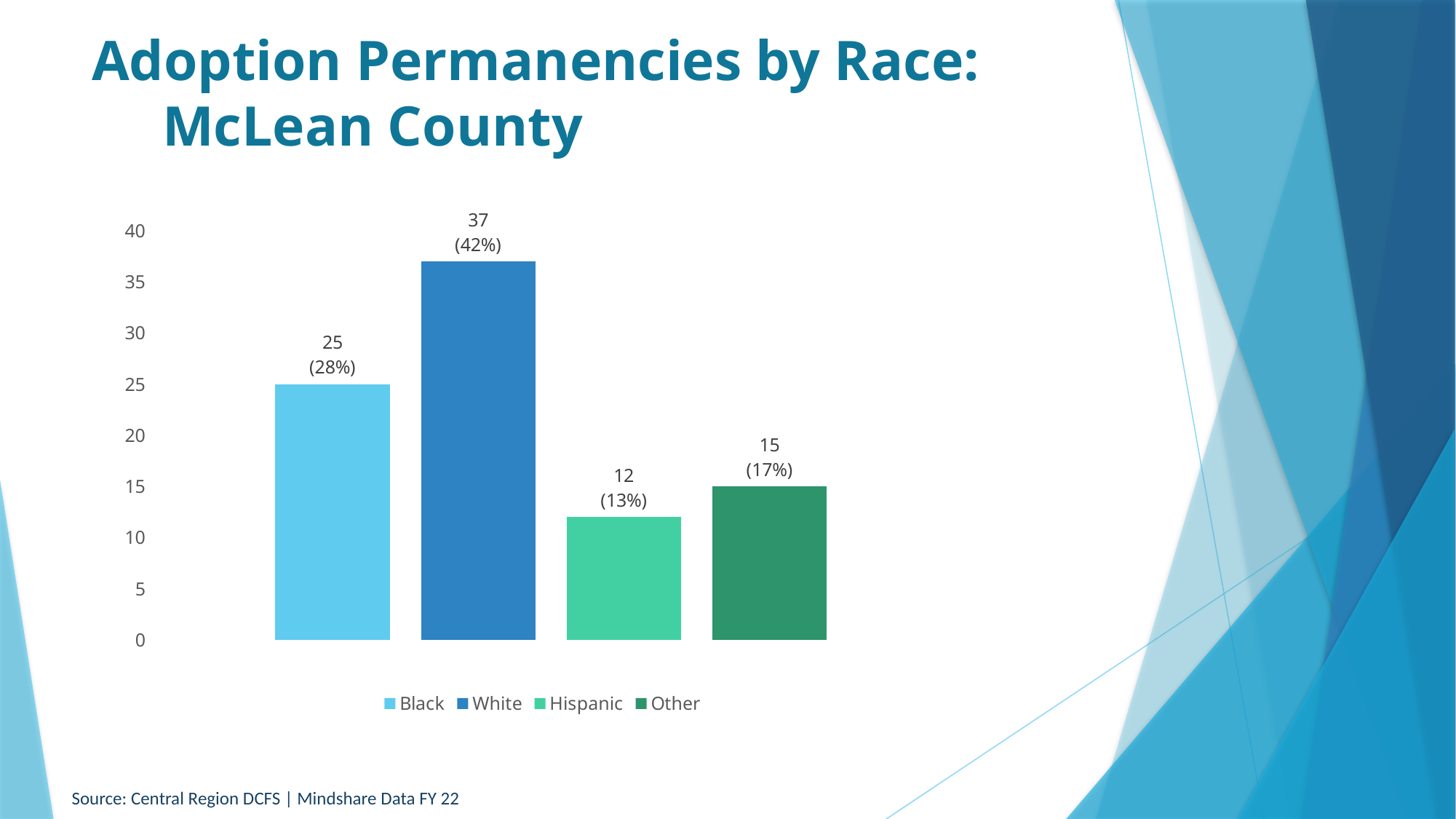
What kind of chart is shown on the slide? Bar chart What is the number of adoption permanencies for White in McLean County? 37 What percentage is shown for Hispanic? 13% Which is larger, the value for Other or the value for Hispanic? Other What is the value for Other? 15 What is the difference between the White and Black values? 12 Which race category has the highest number of adoption permanencies? White Which race category has the lowest number of adoption permanencies? Hispanic How many race categories are shown in the chart? 4 What is the source cited at the bottom of the slide? Central Region DCFS | Mindshare Data FY 22 Is the value for Black greater or less than 20? greater What is the number of adoption permanencies for Black in McLean County? 25